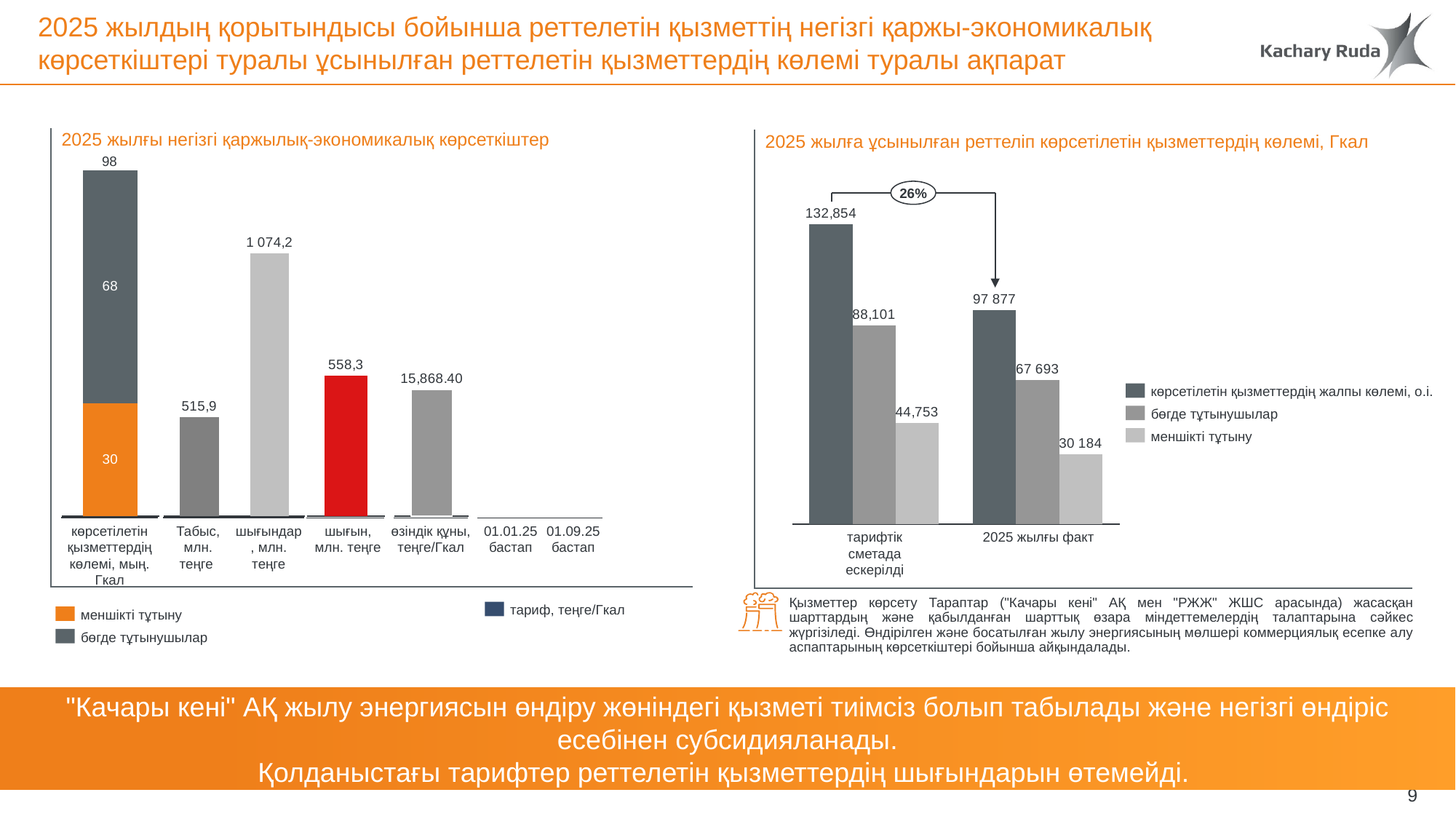
In the right chart, what is the value of 'меншікті тұтыну' for '2025 жылғы факт'? 30 184 In the right chart, which is larger: 'бөгде тұтынушылар' for 'тарифтік сметада ескерілді' or for '2025 жылғы факт'? тарифтік сметада ескерілді In the right chart, how many series does the legend list? 3 In the right chart (2025 жылға ұсынылған реттеліп көрсетілетін қызметтердің көлемі, Гкал), what is the value of 'көрсетілетін қызметтердің жалпы көлемі' for 'тарифтік сметада ескерілді'? 132,854 What kind of chart is the right chart? bar chart In the left chart, what is the value for 'шығындар, млн. теңге'? 1 074,2 In the left chart, what is the value for 'өзіндік құны, теңге/Гкал'? 15,868.40 In the right chart, what percentage is shown in the annotation between the two 'көрсетілетін қызметтердің жалпы көлемі' bars? 26% In the left chart (2025 жылғы негізгі қаржылық-экономикалық көрсеткіштер), what is the value for 'Табыс, млн. теңге'? 515,9 In the left chart, what is the 'меншікті тұтыну' portion of the stacked bar 'көрсетілетін қызметтердің көлемі, мың. Гкал'? 30 In the left chart, what is the total of the stacked bar 'көрсетілетін қызметтердің көлемі, мың. Гкал'? 98 In the right chart, what is the value of 'бөгде тұтынушылар' for '2025 жылғы факт'? 67 693